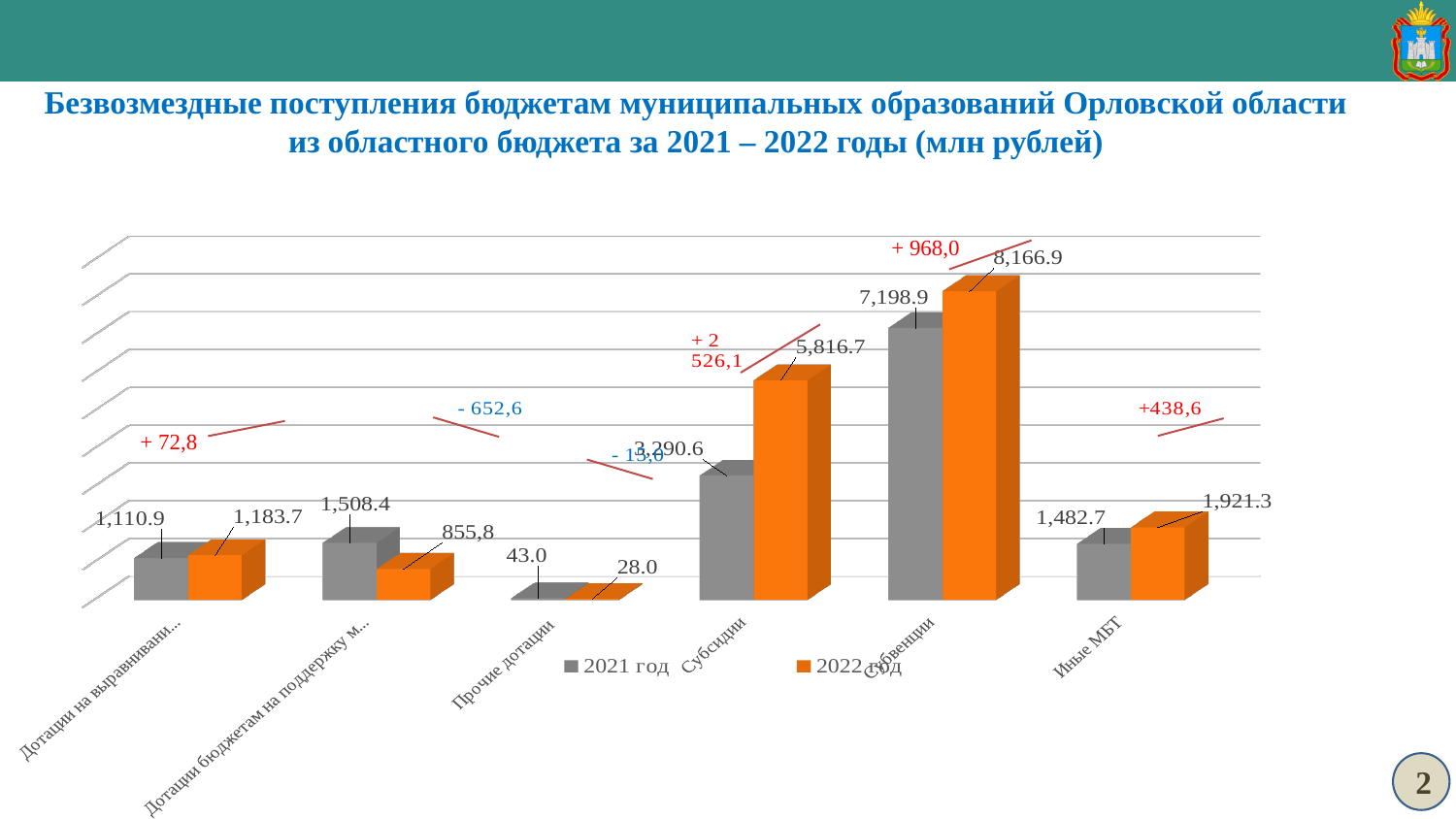
What is the value for Субвенции in the 2021 год series? 7,198.9 By how much did Субвенции increase from 2021 год to 2022 год? 968.0 Which is larger in the 2022 год series: Субсидии or Иные МБТ? Субсидии Which category has the highest value in the 2022 год series? Субвенции What is the value for Иные МБТ in the 2022 год series? 1,921.3 What is the value for Субсидии in the 2022 год series? 5,816.7 What is the value for Прочие дотации in the 2021 год series? 43.0 How many series does the legend list? 2 How many categories are shown on the x axis? 6 Which category has the lowest value in the 2021 год series? Прочие дотации What is the value for Прочие дотации in the 2022 год series? 28.0 What kind of chart is shown on the slide? bar chart